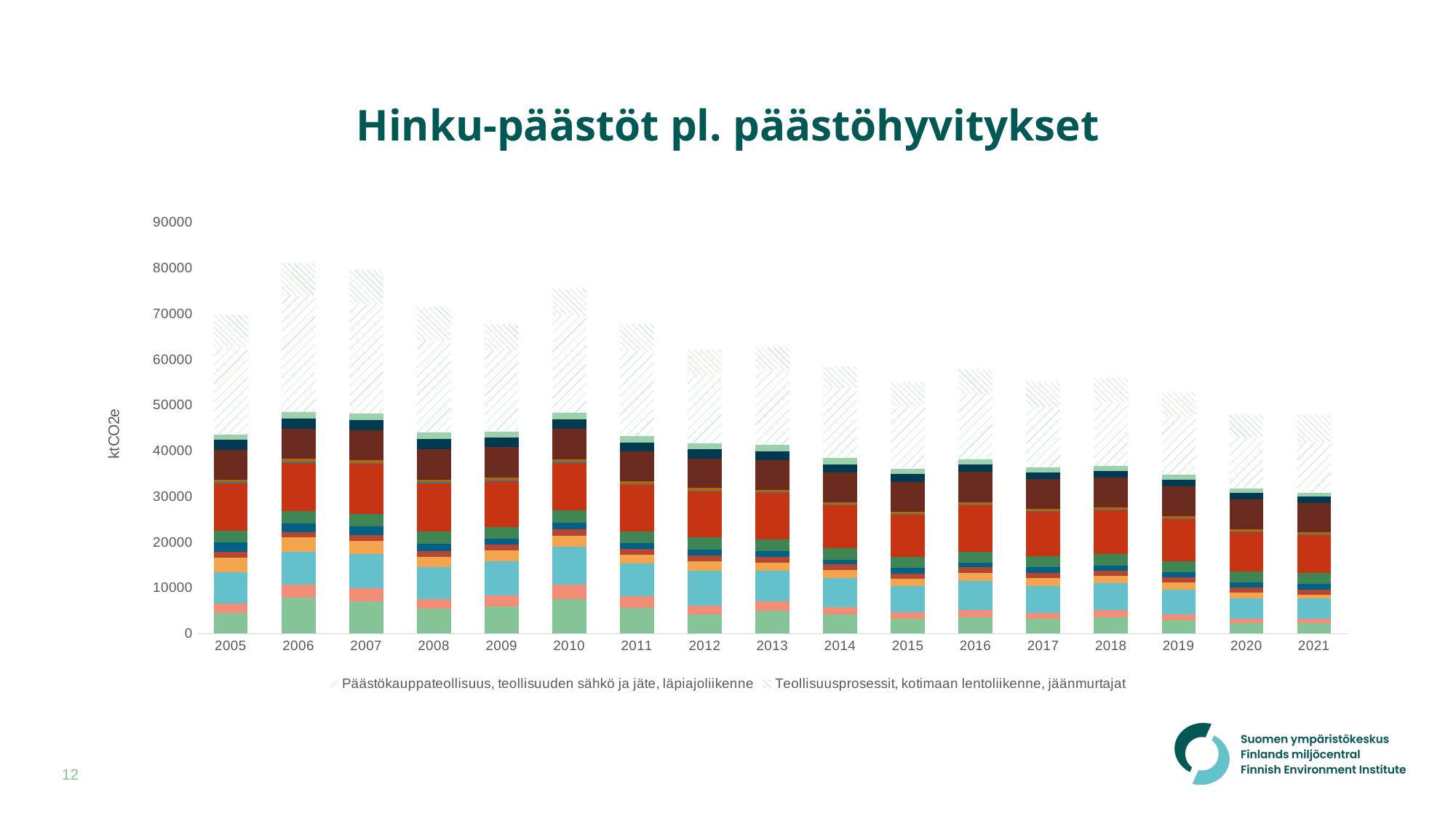
How many entries does the chart legend list? 2 Is the total bar height for 2006 greater or less than 70000? greater Is the total bar height for 2016 greater or less than 60000? less What is the first year shown on the x axis? 2005 What is the last year shown on the x axis? 2021 Which year has the taller total bar, 2006 or 2021? 2006 What kind of chart is shown on the slide? stacked bar chart Do the total emissions generally rise or fall from 2005 to 2021? fall Is the total bar height for 2020 greater or less than 50000? less What unit is given on the y axis of the chart? ktCO2e How many years are shown along the x axis of the chart? 17 Which year has the taller total bar, 2005 or 2010? 2010